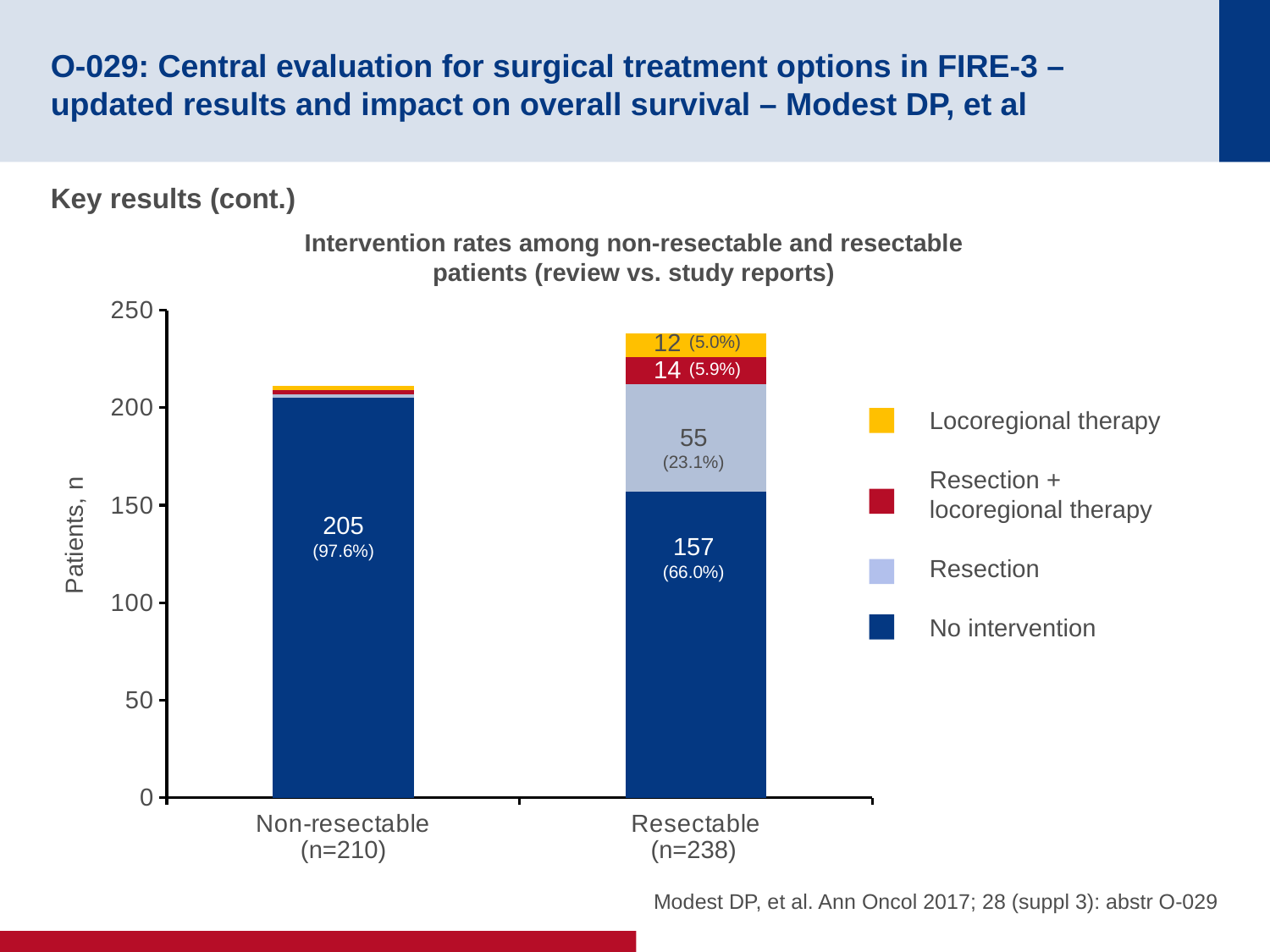
How many series does the legend list? 4 In the Resectable group, which is larger: Resection or Resection + locoregional therapy? Resection What kind of chart is shown on the slide? Stacked bar chart What percentage of Resectable patients had Resection + locoregional therapy? 5.9% How many Non-resectable patients had no intervention? 205 How many Resectable patients had Resection? 55 How many Resectable patients had no intervention? 157 How many Resectable patients had Locoregional therapy? 12 What is the label on the y axis? Patients, n What is the difference in the number of patients with no intervention between the Non-resectable and Resectable groups? 48 What is the total number of patients in the Resectable stacked bar? 238 How many patient categories are shown on the x axis? 2